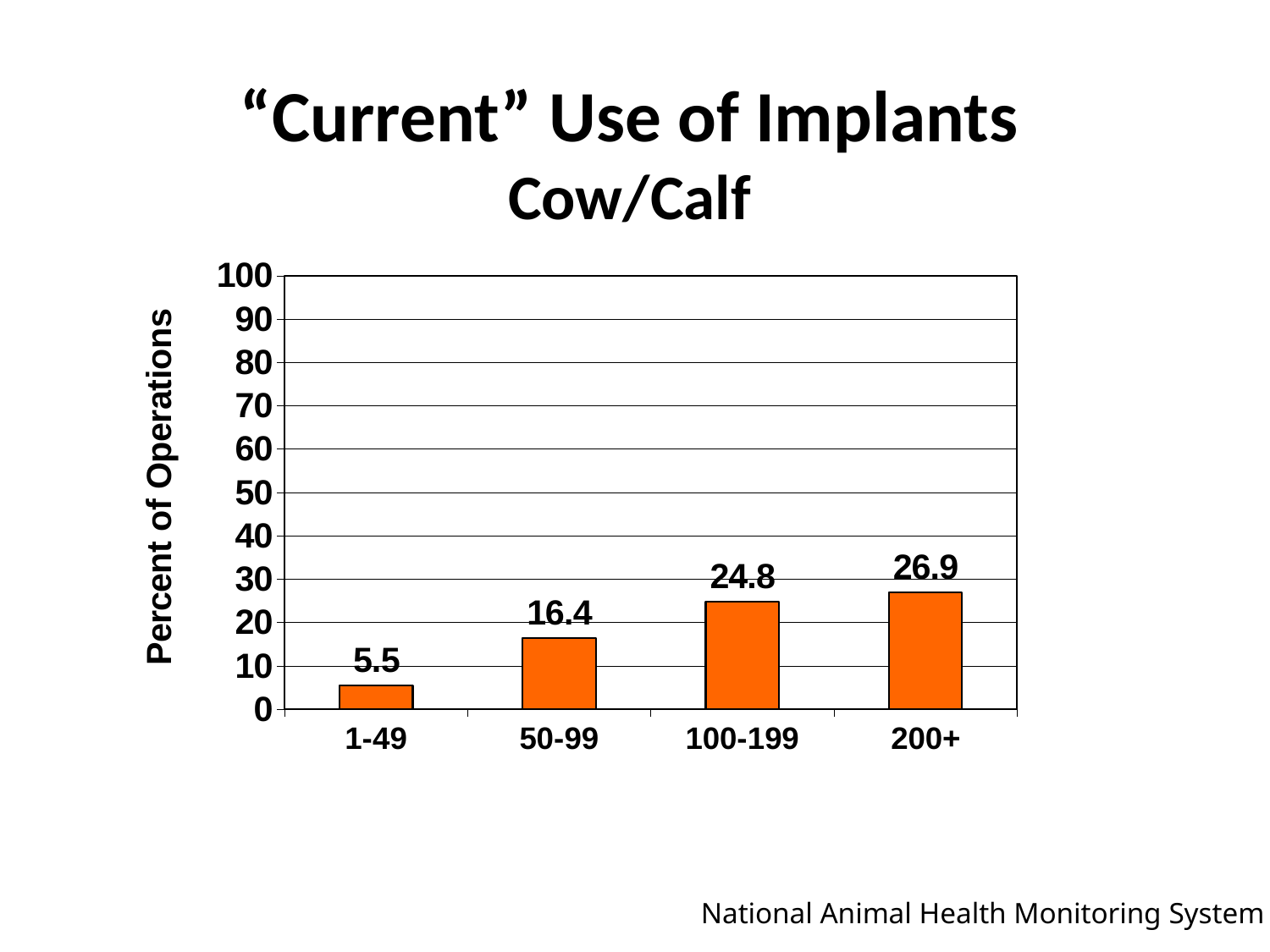
What is the percent of operations for the 50-99 category? 16.4 Which category has the lowest percent of operations? 1-49 What is the difference between the values for 200+ and 1-49? 21.4 What is the percent of operations for the 1-49 category? 5.5 What kind of chart is shown on the slide? bar chart Do the values rise or fall as you move from 1-49 to 200+ along the x axis? rise How many categories are shown on the x axis? 4 What is the percent of operations for the 200+ category? 26.9 Which is larger, the value for 50-99 or the value for 100-199? 100-199 Is the value for 100-199 greater or less than 20? greater Which category has the highest percent of operations? 200+ What is the percent of operations for the 100-199 category? 24.8